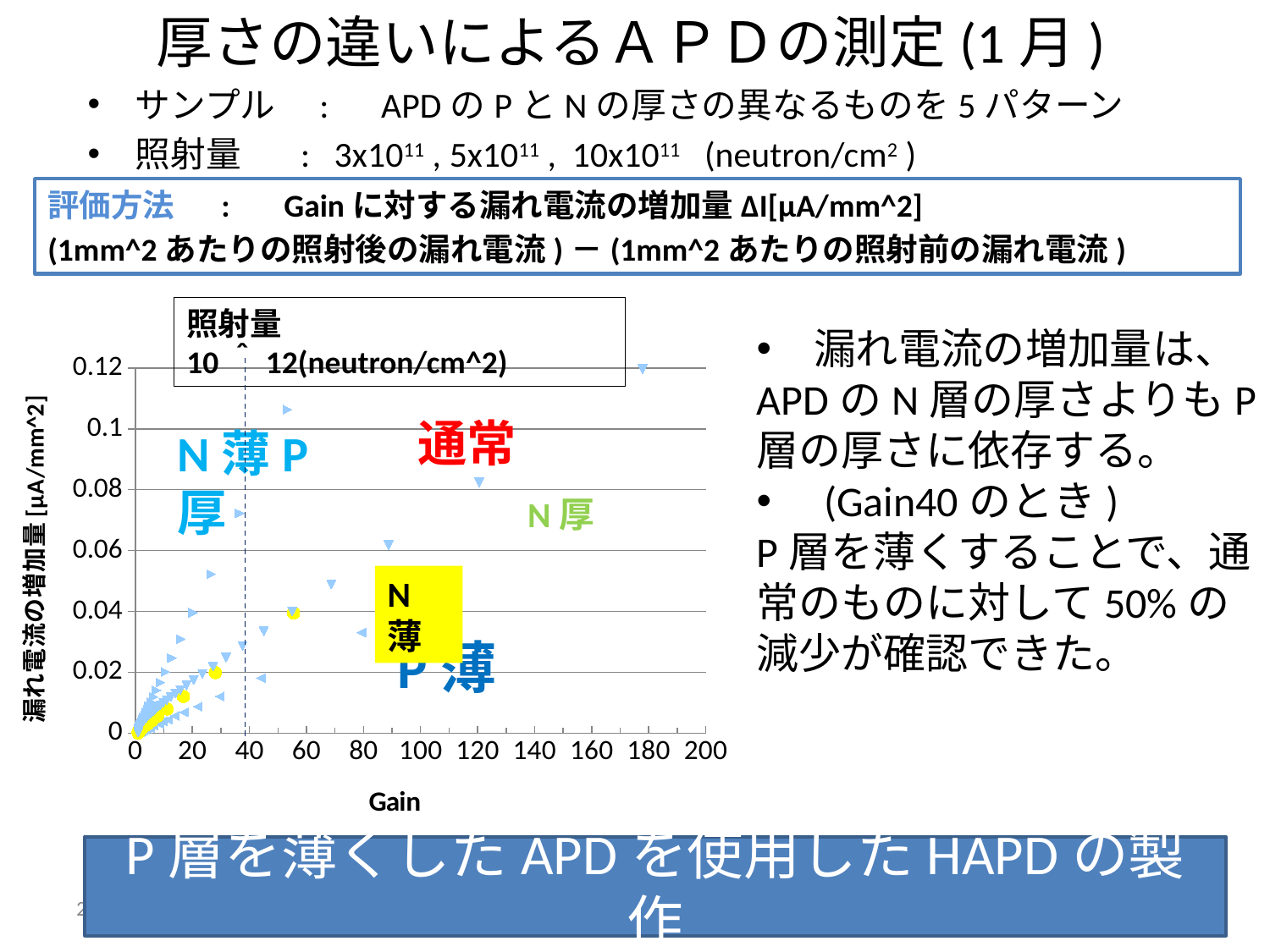
At what Gain value is the dashed vertical line drawn on the chart? 40 Is the value of the light-blue point near Gain 90 greater or less than 0.04? greater How many sample groups are labelled on the chart (通常, N厚, N薄, P薄, N薄P厚)? 5 Is the value of the 通常 point near Gain 120 greater or less than 0.1? less Is the value of the yellow point near Gain 55 greater or less than 0.06? less Do the plotted values generally rise or fall as Gain increases? rise What kind of chart is shown on the slide? scatter chart What is the title printed in the box above the chart? 照射量 10^12(neutron/cm^2)